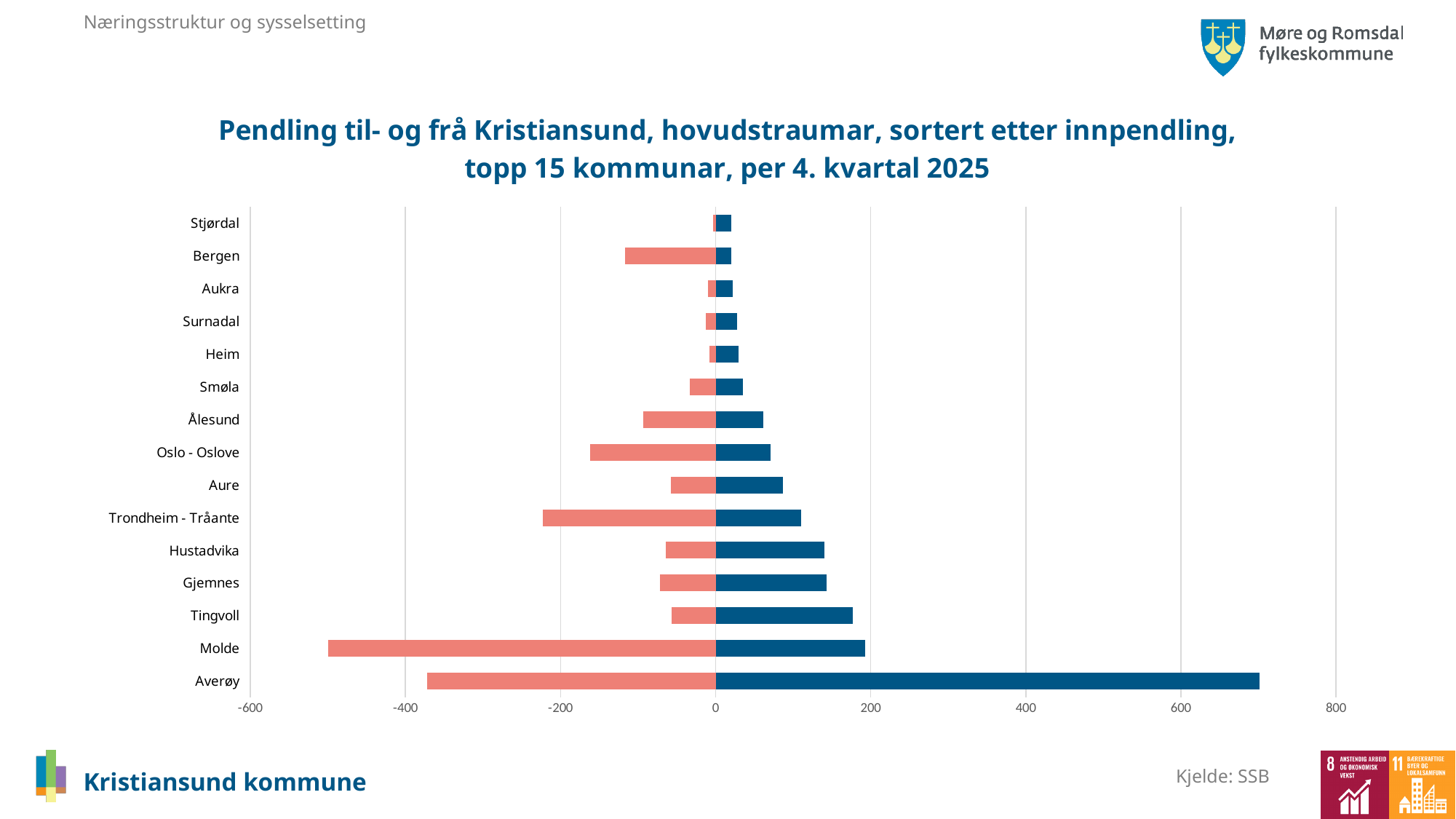
Is the blue bar value for Tingvoll greater or less than 200? less Which has the longer red bar, Molde or Averøy? Molde Which has the longer blue bar, Averøy or Molde? Averøy What is the title of the chart? Pendling til- og frå Kristiansund, hovudstraumar, sortert etter innpendling, topp 15 kommunar, per 4. kvartal 2025 How many municipalities (categories) are listed on the chart? 15 Is the blue bar value for Hustadvika greater or less than 200? less Which municipality has the longest blue (positive) bar? Averøy Do the blue bars get longer or shorter going down the chart from Stjørdal to Averøy? longer Is the blue bar value for Averøy greater or less than 600? greater What kind of chart is shown on the slide? bar chart